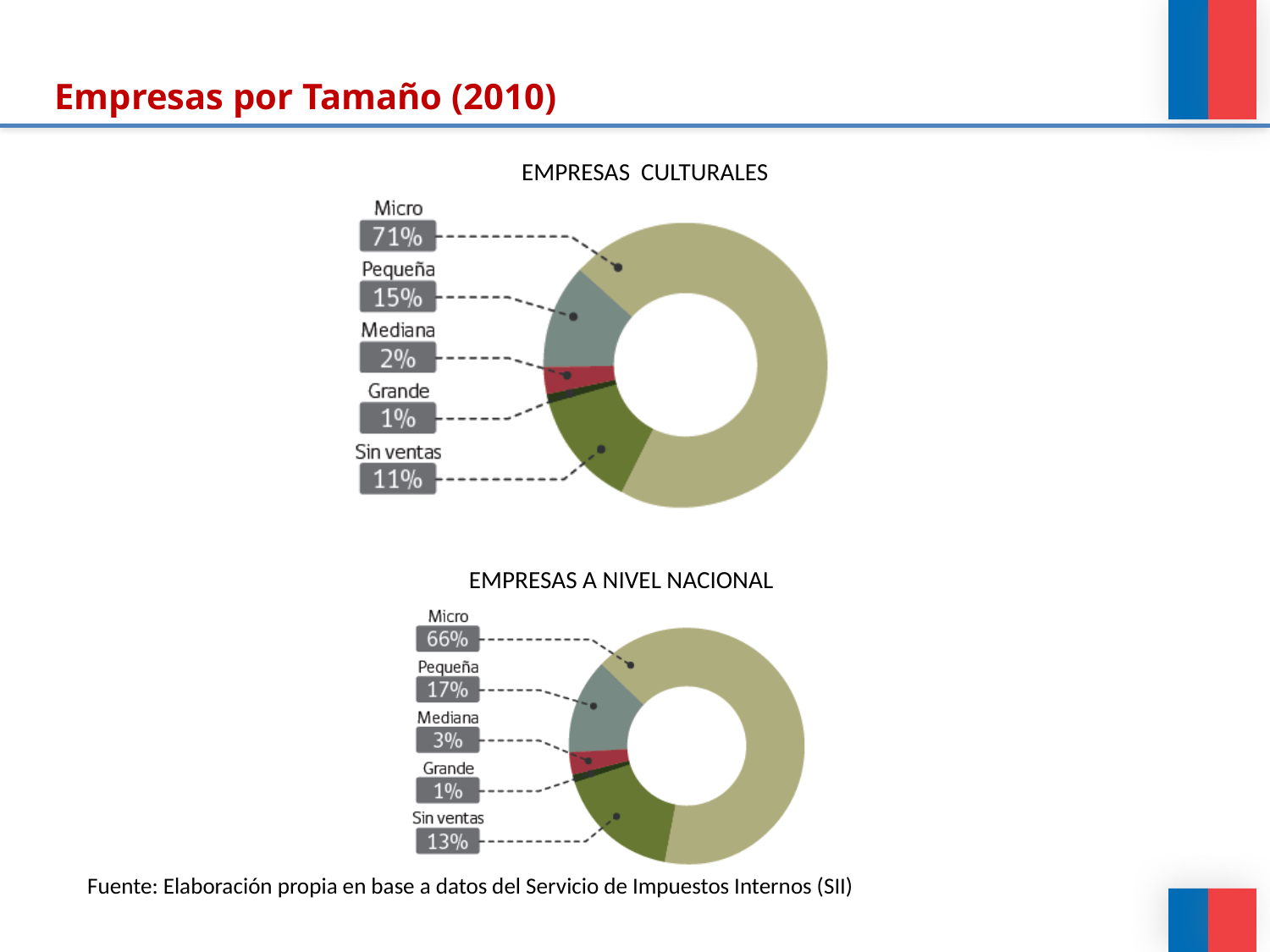
In the EMPRESAS A NIVEL NACIONAL chart, which category has the smallest share? Grande In the EMPRESAS A NIVEL NACIONAL chart, what percentage is shown for Pequeña? 17% What is the title of the top chart on the slide? EMPRESAS CULTURALES In the EMPRESAS CULTURALES chart, what percentage is shown for Sin ventas? 11% Which chart shows a higher percentage for Micro, EMPRESAS CULTURALES or EMPRESAS A NIVEL NACIONAL? EMPRESAS CULTURALES In the EMPRESAS CULTURALES chart, what percentage is shown for Micro? 71% In the EMPRESAS CULTURALES chart, which category has the largest share? Micro In the EMPRESAS A NIVEL NACIONAL chart, which is larger, Sin ventas or Pequeña? Pequeña In the EMPRESAS CULTURALES chart, what is the difference in percentage points between Micro and Pequeña? 56 What kind of chart is used for EMPRESAS A NIVEL NACIONAL? Doughnut chart In the EMPRESAS A NIVEL NACIONAL chart, what percentage is shown for Mediana? 3% How many categories does the EMPRESAS CULTURALES chart show? 5